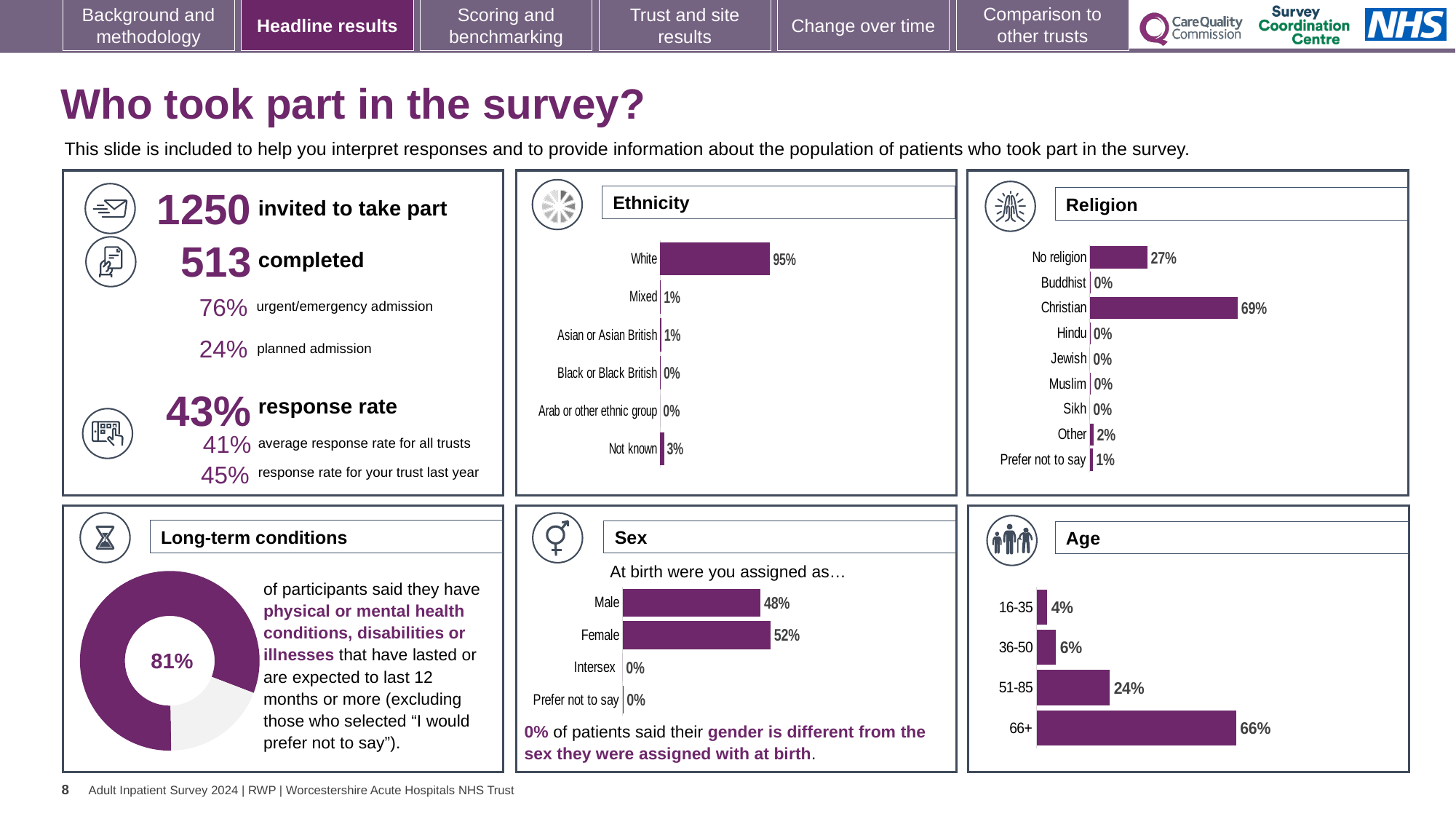
In the Long-term conditions donut chart, what share of participants said they have long-term conditions? 81% In the Age chart, what is the value for 51-85? 24% In the Religion chart, what is the value for No religion? 27% In the Religion chart, which category has the highest value? Christian In the Age chart, which age group has the highest value? 66+ In the Sex chart, what is the value for Male? 48% In the Sex chart, which is larger, Male or Female? Female In the Religion chart, what is the difference between Christian and No religion? 42% What type of chart is used for the Ethnicity data? Bar chart How many age groups are shown in the Age chart? 4 In the Ethnicity chart, what percentage of respondents were Not known? 3% In the Ethnicity chart, what percentage of respondents were White? 95%